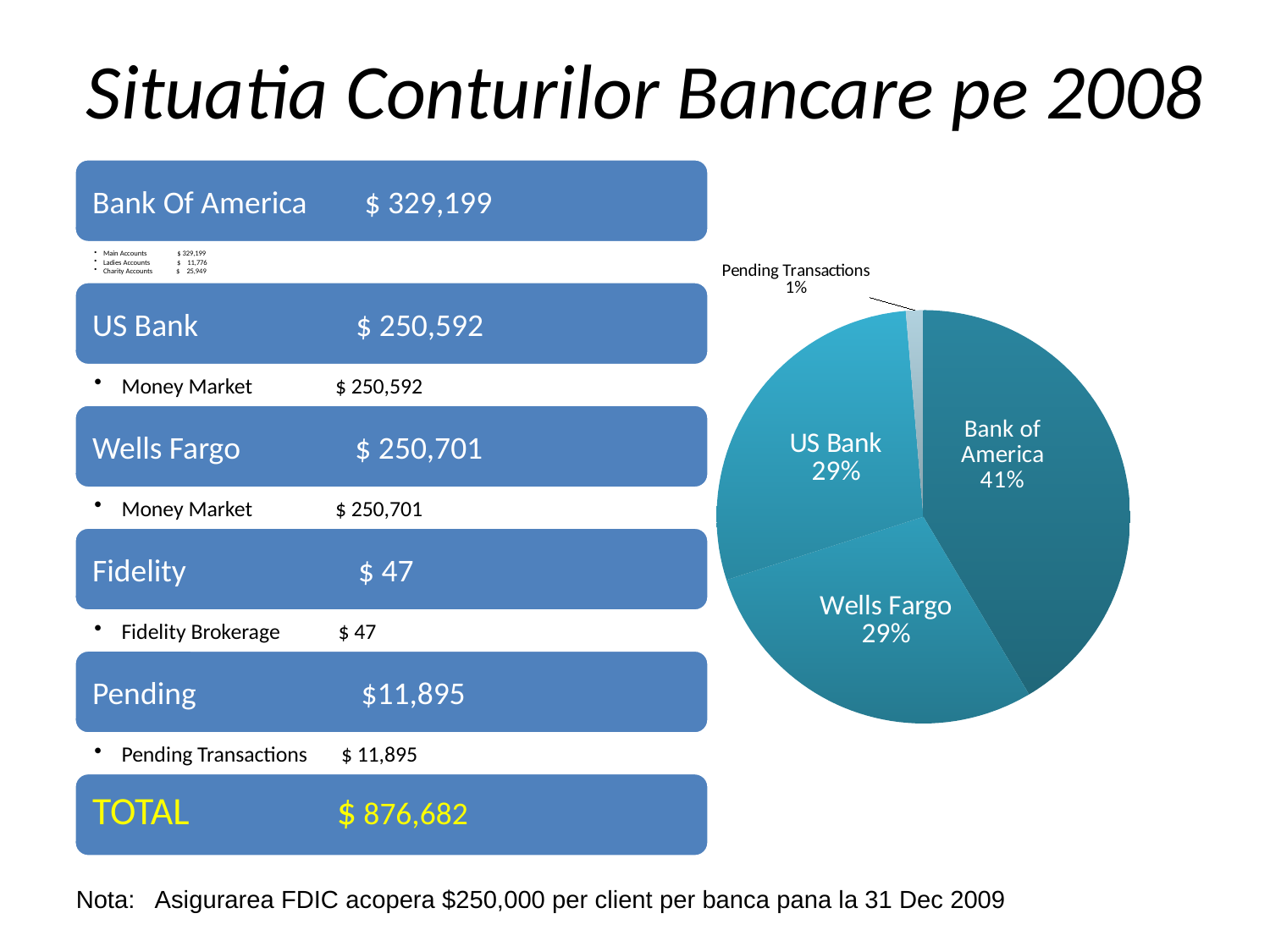
What share of the pie chart does Wells Fargo account for? 29% Which slice is larger in the pie chart, Bank of America or US Bank? Bank of America What share of the pie chart does Bank of America represent? 41% What percentage of the pie chart is US Bank? 29% What is the title of the slide containing the pie chart? Situatia Conturilor Bancare pe 2008 Which labelled slice of the pie chart is the smallest? Pending Transactions What type of chart is shown on the slide? Pie chart By how many percentage points does the Bank of America slice exceed the US Bank slice in the pie chart? 12 By how many percentage points does the Wells Fargo slice exceed the Pending Transactions slice? 28 Which slice is larger in the pie chart, Wells Fargo or Pending Transactions? Wells Fargo Which slice of the pie chart is the largest? Bank of America